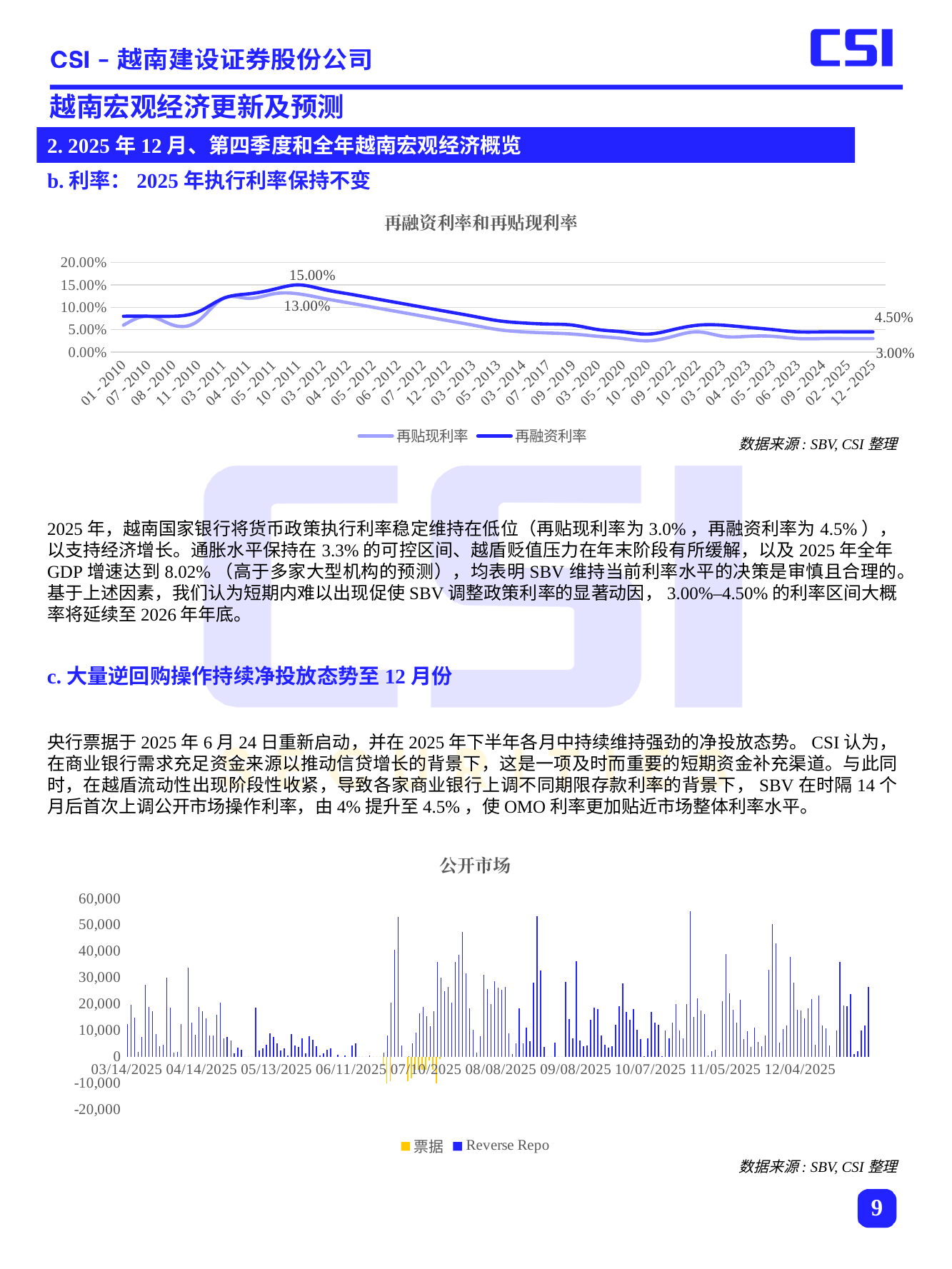
In the '再融资利率和再贴现利率' chart, what is the value of 再贴现利率 at 12-2025? 3.00% In the '再融资利率和再贴现利率' chart, which series is higher at 12-2025, 再融资利率 or 再贴现利率? 再融资利率 In the '再融资利率和再贴现利率' chart, what is the difference between the labelled peak values 15.00% and 13.00%? 2.00% In the '再融资利率和再贴现利率' chart, what is the value of 再融资利率 at 12-2025? 4.50% What kind of chart is the '公开市场' chart? bar chart In the '再融资利率和再贴现利率' chart, what is the labelled peak value of 再贴现利率 around 10-2011? 13.00% How many series does the legend of the '再融资利率和再贴现利率' chart list? 2 What kind of chart is the '再融资利率和再贴现利率' chart? line chart In the '再融资利率和再贴现利率' chart, what is the labelled peak value of 再融资利率 around 10-2011? 15.00% In the '再融资利率和再贴现利率' chart, what is the difference between 再融资利率 and 再贴现利率 at 12-2025? 1.50% In the '再融资利率和再贴现利率' chart, does 再融资利率 rise or fall from 10-2011 to 12-2025? fall What are the two legend entries of the '公开市场' chart? 票据, Reverse Repo